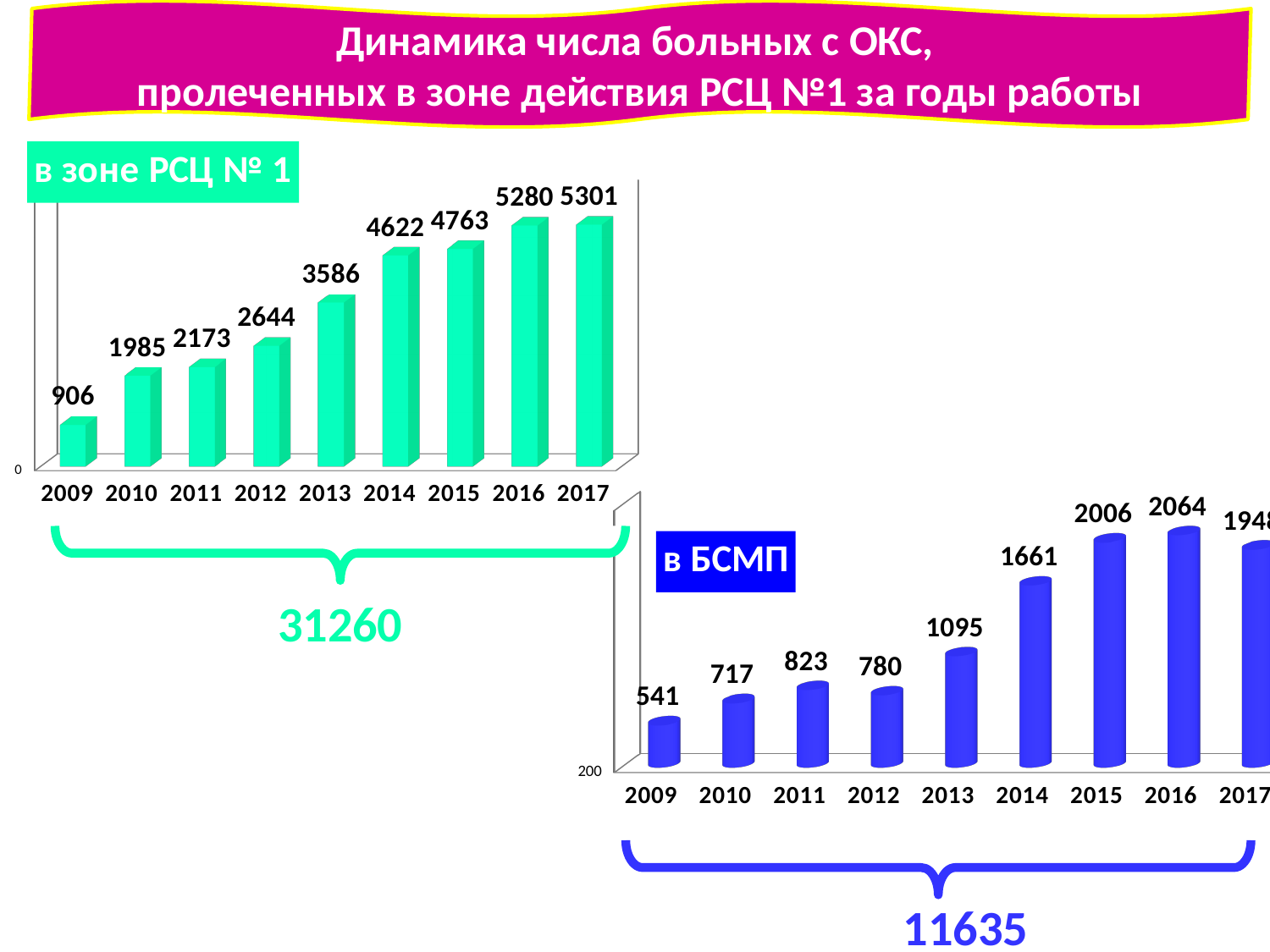
In the chart 'в зоне РСЦ № 1', what is the difference between the values for 2013 and 2012? 942 In the chart 'в зоне РСЦ № 1', how many years are shown on the x axis? 9 In the chart 'в БСМП', which is larger, the value for 2011 or the value for 2012? 2011 In the chart 'в зоне РСЦ № 1', what is the value for 2009? 906 In the chart 'в БСМП', what is the difference between the values for 2016 and 2015? 58 In the chart 'в БСМП', which year has the lowest value? 2009 What kind of chart is 'в зоне РСЦ № 1'? bar chart In the chart 'в БСМП', what is the value for 2010? 717 In the chart 'в БСМП', what is the value for 2013? 1095 In the chart 'в зоне РСЦ № 1', which year has the highest value? 2017 In the chart 'в зоне РСЦ № 1', what is the value for 2014? 4622 In the chart 'в зоне РСЦ № 1', which year has the lowest value? 2009